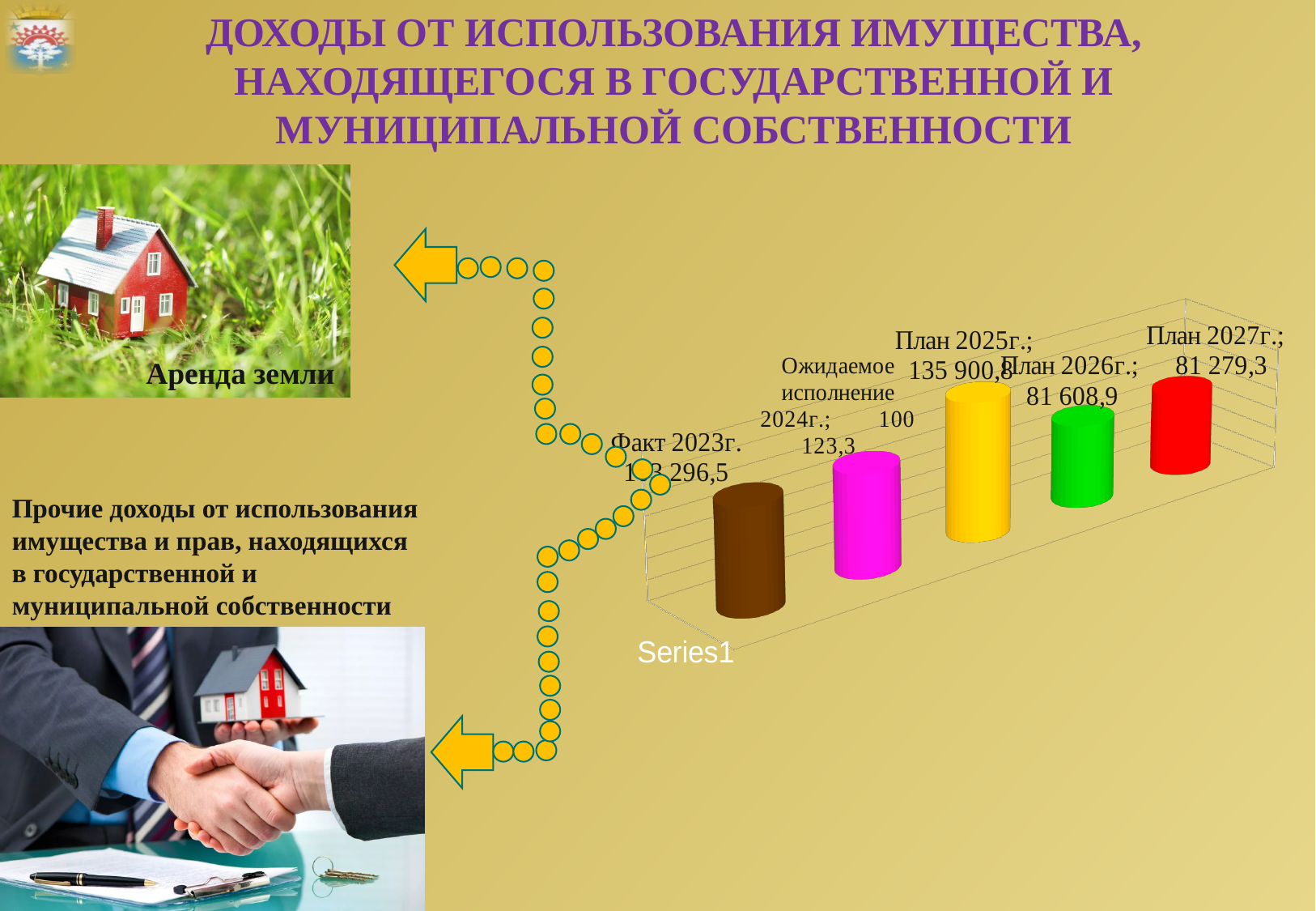
What is the value for План 2026г. in the chart? 81 608,9 Which is larger: the value for Ожидаемое исполнение 2024г. or the value for План 2026г.? Ожидаемое исполнение 2024г. What is the value for План 2027г. in the chart? 81 279,3 What is the difference between the values for План 2025г. and Ожидаемое исполнение 2024г.? 35 777,5 Which category has the highest value in the chart? План 2025г. How many categories are plotted in the chart? 5 Which is larger: the value for План 2025г. or the value for План 2027г.? План 2025г. What kind of chart is shown on the slide? bar chart What is the difference between the values for План 2026г. and План 2027г.? 329,6 What is the name of the series shown in the chart legend? Series1 What is the value for Ожидаемое исполнение 2024г. in the chart? 100 123,3 What is the value for План 2025г. in the chart? 135 900,8